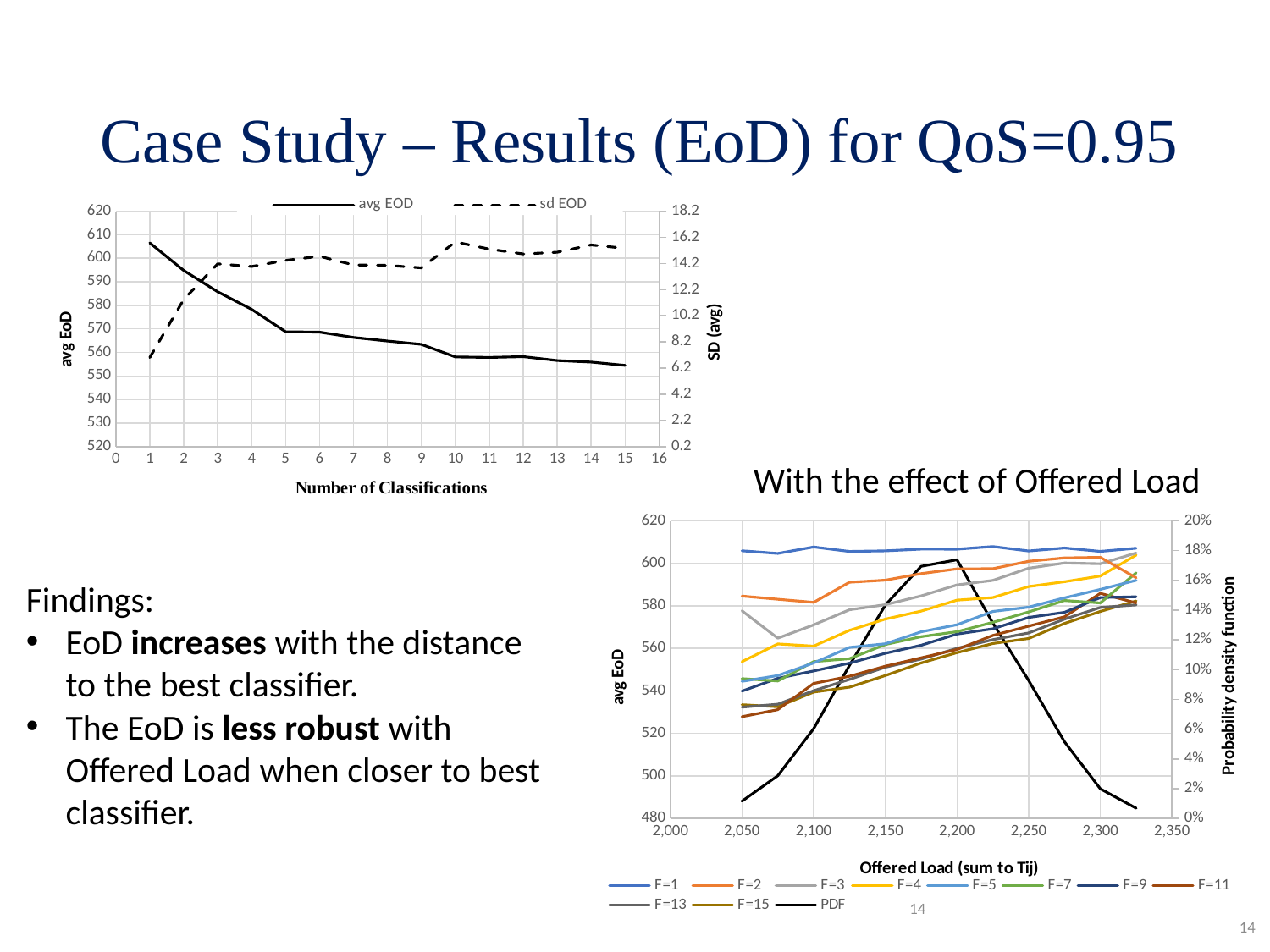
In the bottom-right chart (With the effect of Offered Load), which F series has the highest avg EoD across the offered loads? F=1 In the top-left chart, does avg EOD rise or fall as the Number of Classifications increases? fall In the top-left chart, does sd EOD rise or fall as the Number of Classifications increases? rise In the top-left chart, is the avg EOD value at 15 classifications greater or less than 560? less How many series does the legend of the bottom-right chart (With the effect of Offered Load) list? 11 What kind of chart is the top-left chart with avg EOD and sd EOD? line chart In the bottom-right chart (With the effect of Offered Load), does the avg EoD for F=4 rise or fall as Offered Load increases? rise In the bottom-right chart (With the effect of Offered Load), is the PDF value at an offered load of 2,200 greater or less than 16%? greater In the top-left chart, which series is drawn with a dashed line? sd EOD How many series does the legend of the top-left chart list? 2 In the bottom-right chart (With the effect of Offered Load), is the avg EoD for F=15 at an offered load of 2,050 greater or less than 540? less